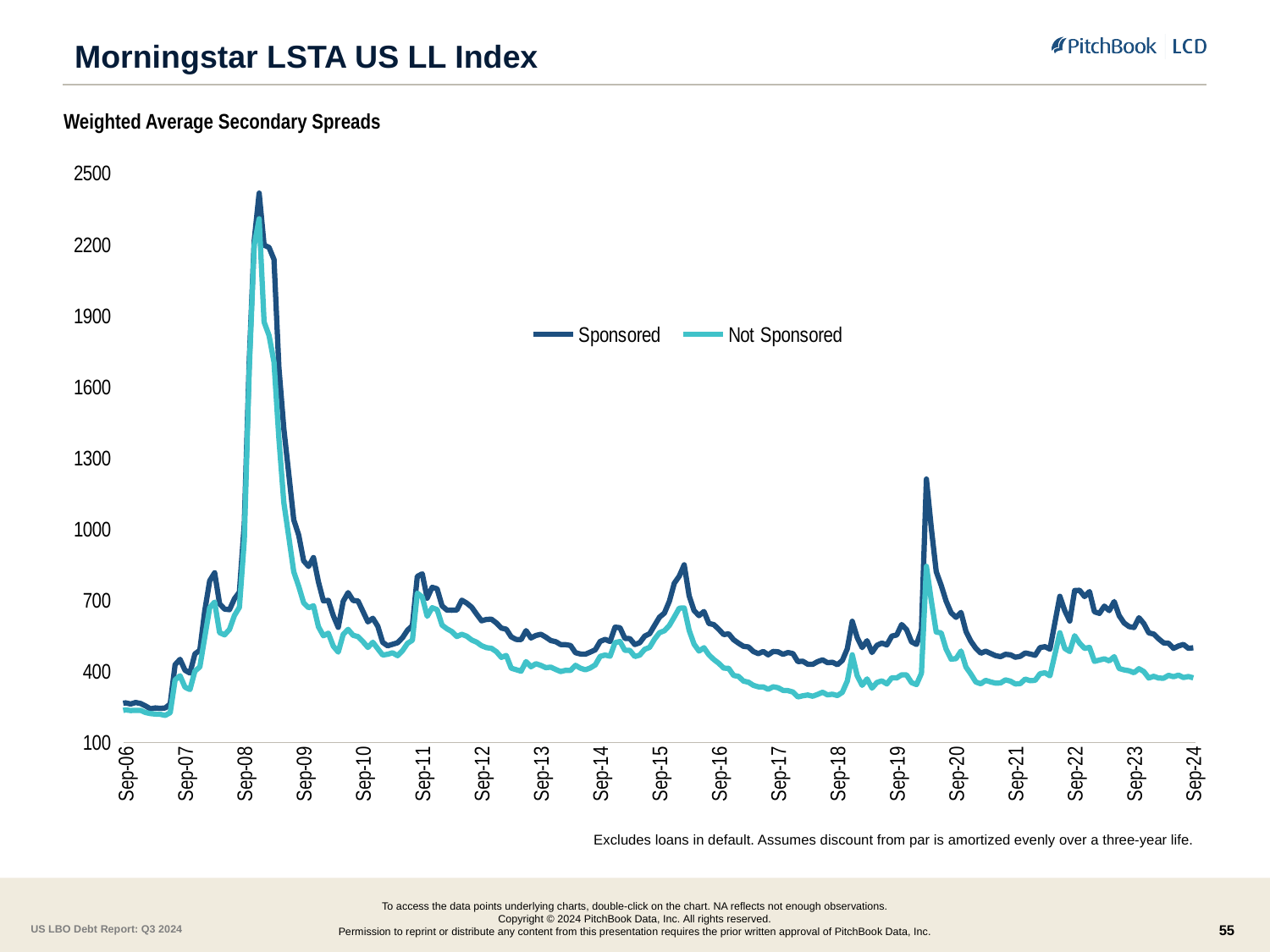
What type of chart is shown on the slide? Line chart How many year labels are shown on the x axis? 19 What are the two series named in the legend? Sponsored and Not Sponsored Is the value for Sponsored at Sep-24 greater or less than 700? less Is the value for Not Sponsored at Sep-24 greater or less than 400? less What is the title of the chart? Weighted Average Secondary Spreads Does the Sponsored series rise or fall between Sep-22 and Sep-24? Fall Is the value for Sponsored at Sep-06 greater or less than 400? less At Sep-24, which series has the larger value, Sponsored or Not Sponsored? Sponsored Which series reaches the higher peak value over the whole period? Sponsored How many series does the legend list? 2